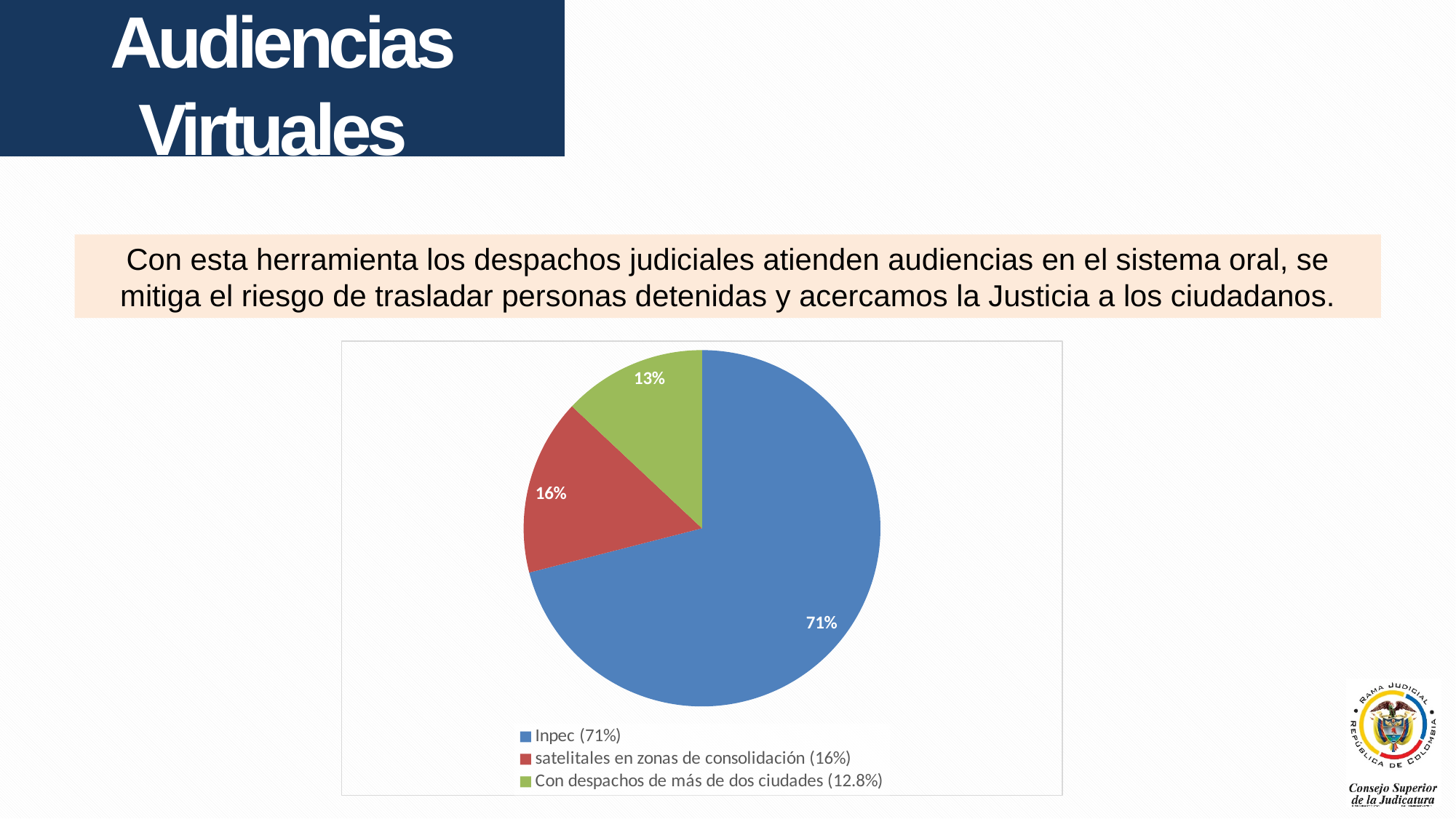
What is the difference in percentage points between the Inpec slice (71%) and the 'satelitales en zonas de consolidación' slice (16%)? 55 Which is larger: the Inpec slice or the 'satelitales en zonas de consolidación' slice? Inpec What percentage does the legend give for 'Con despachos de más de dos ciudades'? 12.8% How many entries does the legend list? 3 What colour is the Inpec slice in the pie chart? blue Which category has the largest slice of the pie? Inpec What kind of chart is shown on the slide? pie chart How many slices does the pie chart have? 3 Which category has the smallest slice of the pie? Con despachos de más de dos ciudades What percentage label is shown on the green slice of the pie? 13% What share of the pie does the 'satelitales en zonas de consolidación' slice represent? 16% What share of the pie does the Inpec slice represent? 71%